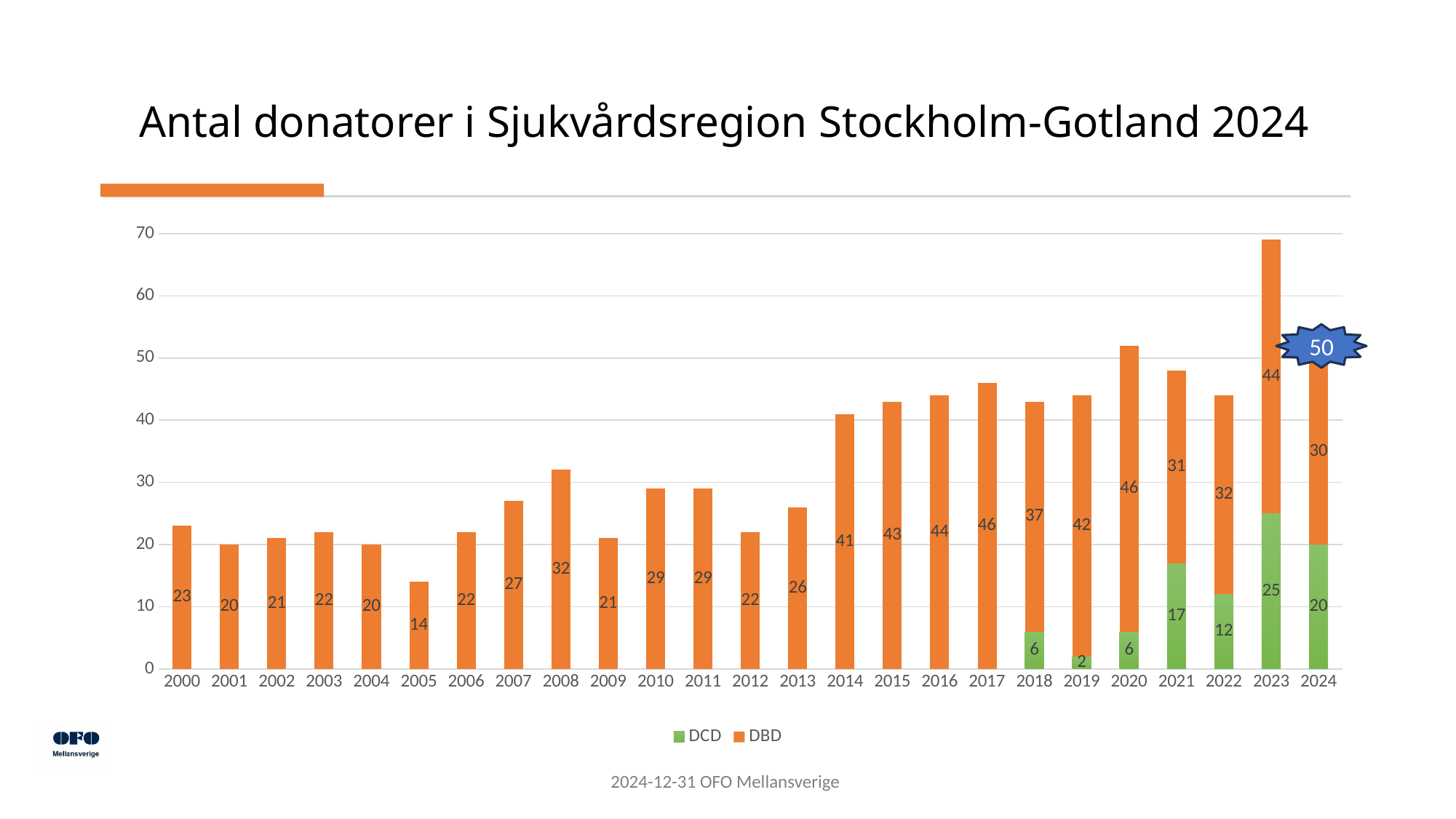
Which year has the larger DCD value, 2021 or 2022? 2021 What is the total of the stacked bar for 2023? 69 Which year has the lowest DBD value? 2005 How many series does the legend list? 2 Which year has the highest DCD value? 2023 Is the total for 2020 greater or less than 50? greater What is the difference between the DBD values for 2017 and 2018? 9 What is the total of the stacked bar for 2021? 48 What is the DCD value for 2023? 25 What kind of chart is shown on the slide? Stacked bar chart How many years are shown on the x axis? 25 What is the DBD value for 2005? 14